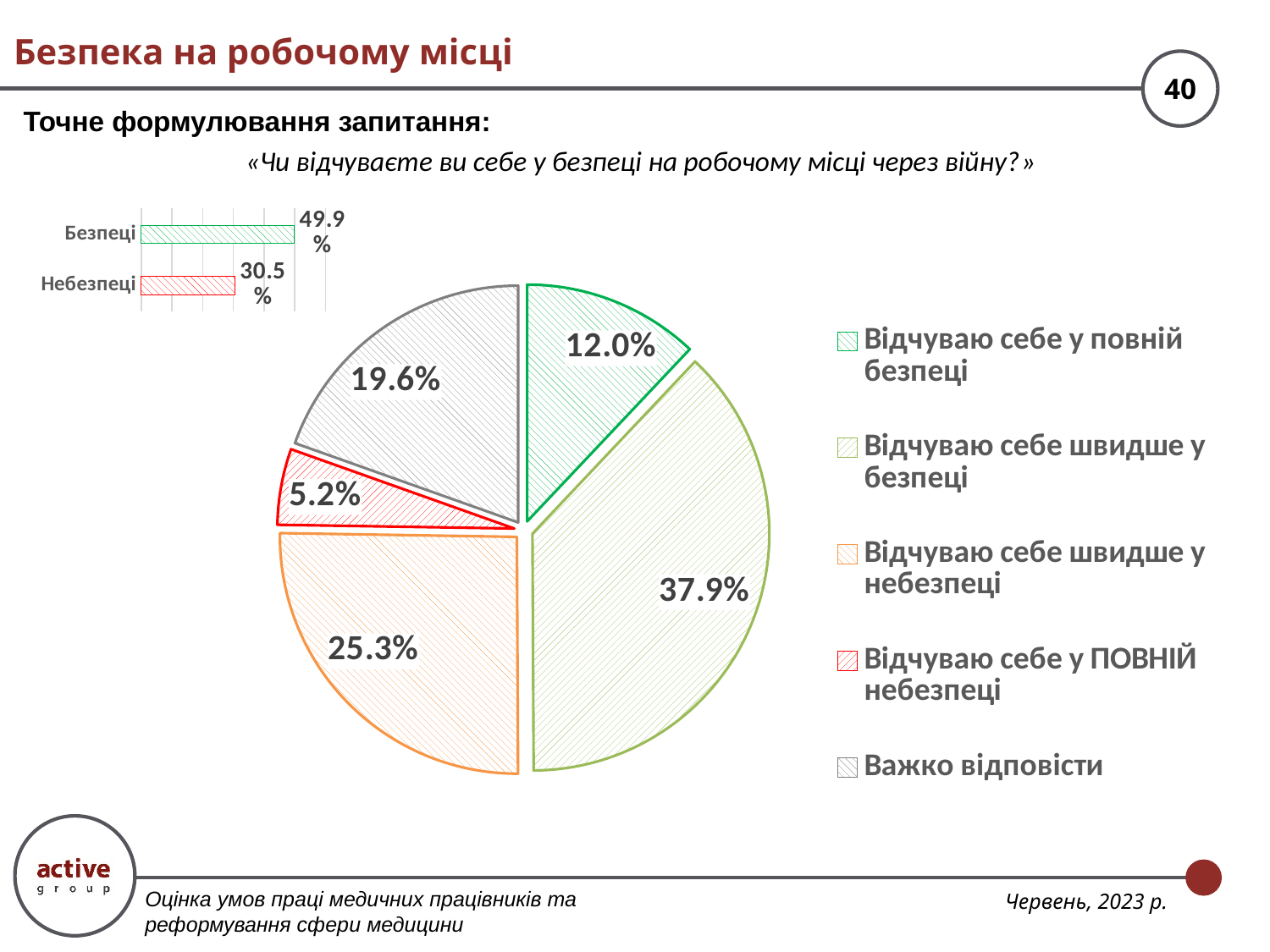
In the pie chart, what share of respondents answered "Відчуваю себе у повній безпеці"? 12.0% In the pie chart, which answer has the largest share? Відчуваю себе швидше у безпеці In the small bar chart in the top-left, what is the value for "Безпеці"? 49.9% In the pie chart, what share of respondents answered "Важко відповісти"? 19.6% In the small bar chart in the top-left, what is the difference between the values for "Безпеці" and "Небезпеці"? 19.4% In the pie chart, what share of respondents answered "Відчуваю себе швидше у безпеці"? 37.9% In the pie chart, which answer has the smallest share? Відчуваю себе у ПОВНІЙ небезпеці In the small bar chart in the top-left, what is the value for "Небезпеці"? 30.5% In the pie chart, which is larger: the share for "Важко відповісти" or the share for "Відчуваю себе у повній безпеці"? Важко відповісти How many slices does the pie chart have? 5 What type of chart is the small chart in the top-left of the slide? Bar chart In the pie chart, what is the difference between the shares for "Відчуваю себе швидше у безпеці" and "Відчуваю себе швидше у небезпеці"? 12.6%